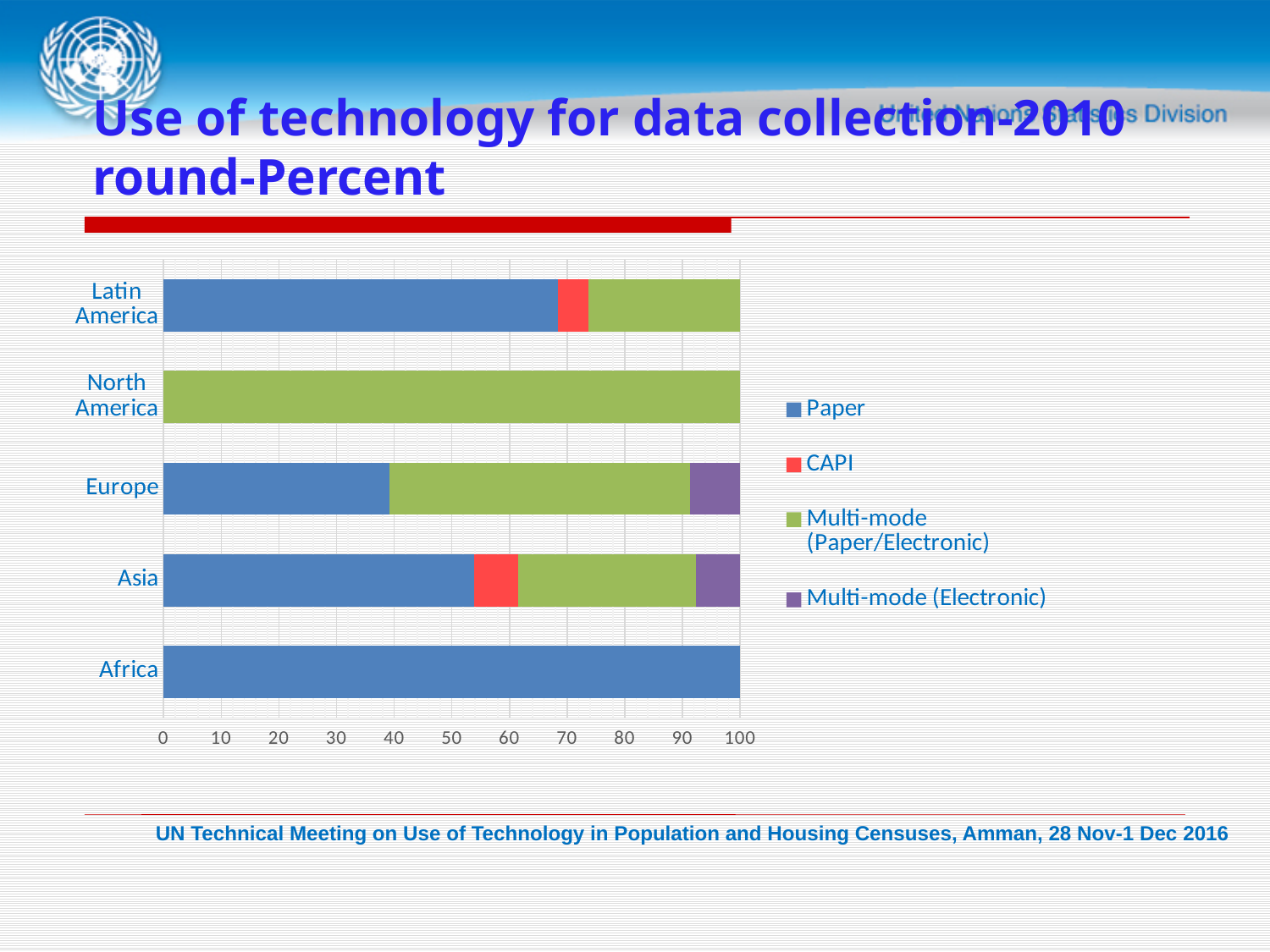
How many regions are shown on the chart? 5 What kind of chart is shown on the slide? Stacked bar chart What is the Multi-mode (Paper/Electronic) value for North America? 100 Which colour represents CAPI in the legend? Red What is the Paper value for Africa? 100 Is the Paper value for Asia greater or less than 50? greater Is the CAPI value for Asia greater or less than 10? less Which has the larger Paper value, Europe or Asia? Asia Which region has the highest Paper value? Africa How many series does the legend list? 4 Which region has the lowest Paper value? North America Is the Paper value for Europe greater or less than 30? greater